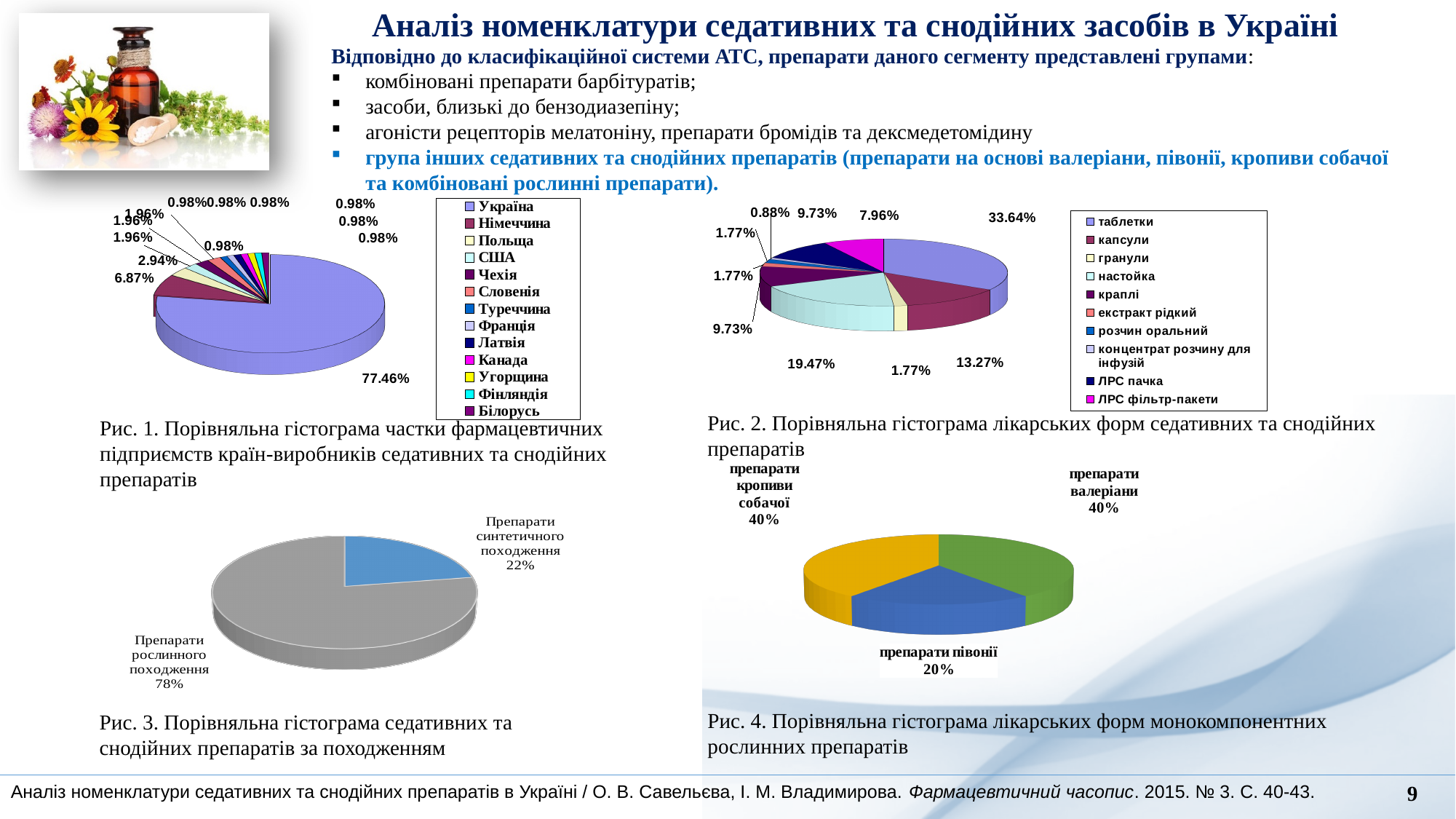
In the chart in Рис. 3, what is the difference between the shares of Препарати рослинного походження and Препарати синтетичного походження? 56% In the chart in Рис. 4, which category has the smallest share? препарати півонії In the chart in Рис. 4, what share do препарати валеріани have? 40% How many slices does the chart in Рис. 4 have? 3 What type of chart is shown in Рис. 2? pie chart In the chart in Рис. 3, what share do Препарати рослинного походження have? 78% In the chart in Рис. 1, what share does Україна have? 77.46% How many entries does the legend of the chart in Рис. 1 list? 13 In the chart in Рис. 2, what share do таблетки have? 33.64% In the chart in Рис. 3, what share do Препарати синтетичного походження have? 22% In the chart in Рис. 1, which country has the largest share? Україна In the chart in Рис. 4, what share do препарати півонії have? 20%